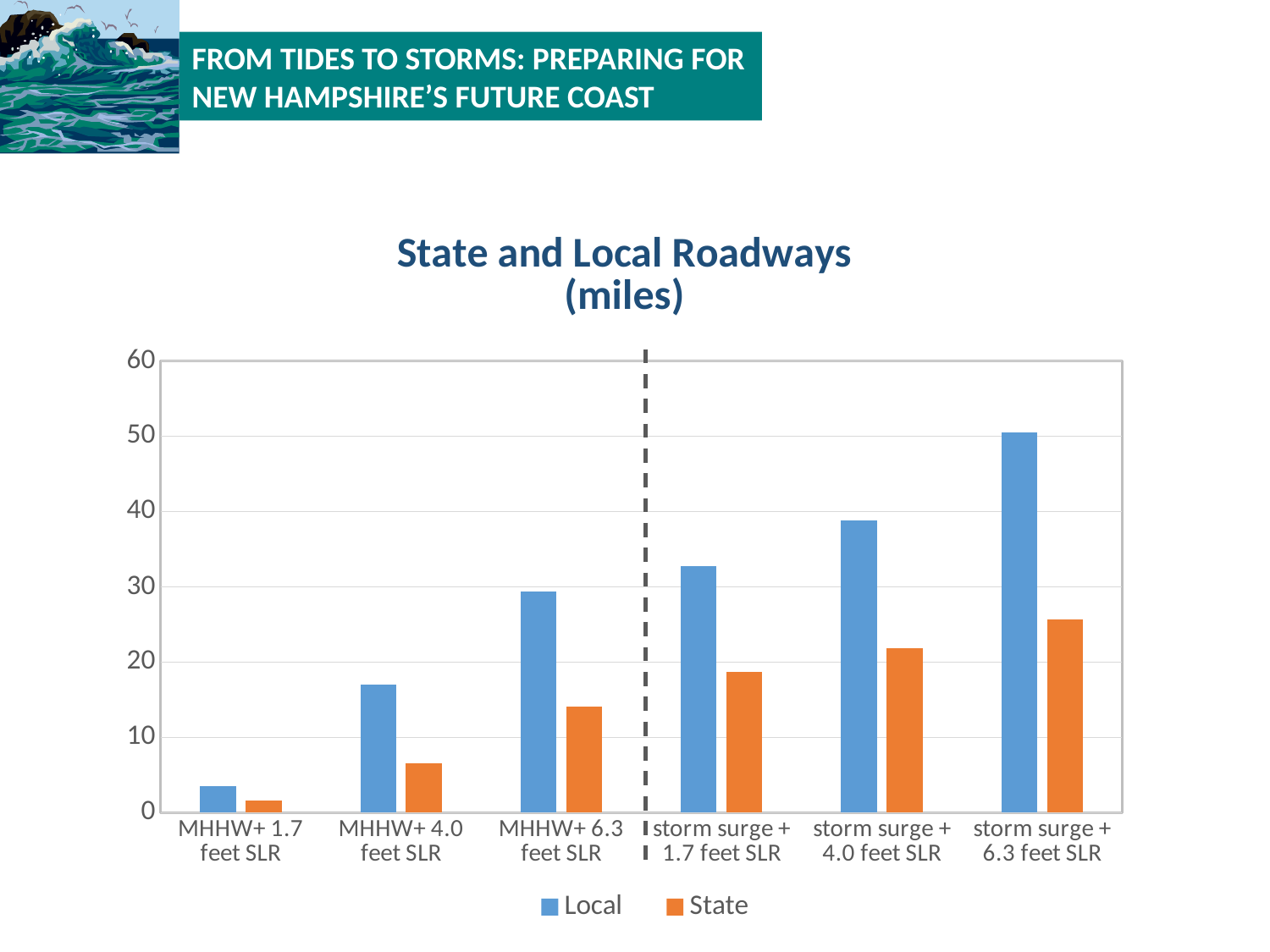
Which is larger, the Local value for MHHW+ 6.3 feet SLR or the State value for storm surge + 6.3 feet SLR? Local value for MHHW+ 6.3 feet SLR How many series does the legend list? 2 What kind of chart is shown on the slide? bar chart Do the Local values rise or fall from left to right across the categories? rise How many categories are shown on the x axis? 6 Which category has the highest Local value? storm surge + 6.3 feet SLR What is the title of the chart? State and Local Roadways (miles) Which category has the lowest State value? MHHW+ 1.7 feet SLR Which colour represents the State series? orange Is the State value for MHHW+ 4.0 feet SLR greater or less than 10? less